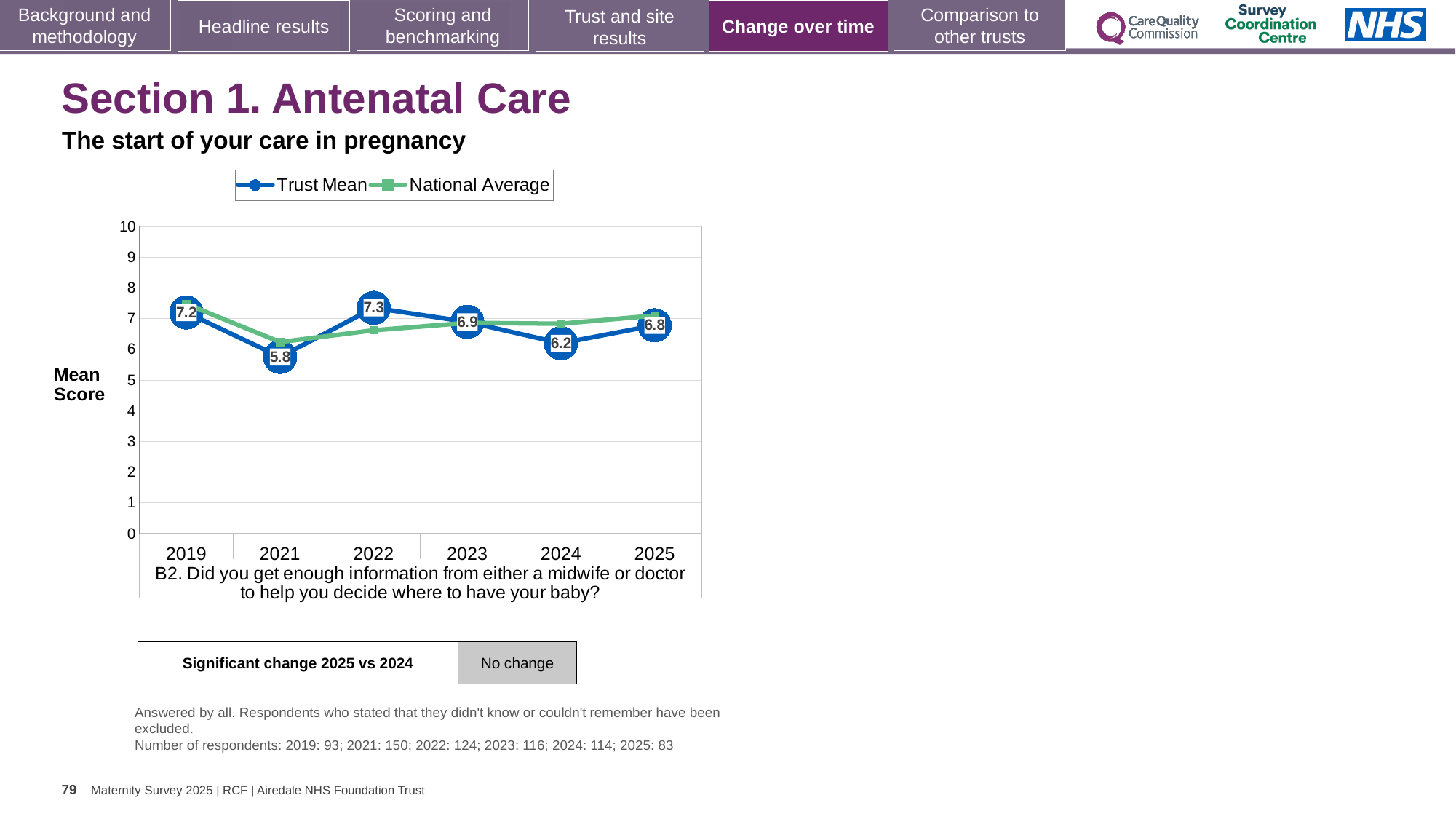
What is the Trust Mean value for 2019? 7.2 How many series does the legend list? 2 In which year is the Trust Mean highest? 2022 What is the Trust Mean value for 2021? 5.8 What kind of chart is shown on the slide? line chart What is the difference between the Trust Mean in 2022 and in 2021? 1.5 Is the National Average value for 2021 greater or less than 7? less How many years are shown on the x axis? 6 Did the Trust Mean rise or fall from 2024 to 2025? rise In which year is the Trust Mean lowest? 2021 Which year has the larger Trust Mean, 2023 or 2024? 2023 What is the Trust Mean value for 2025? 6.8